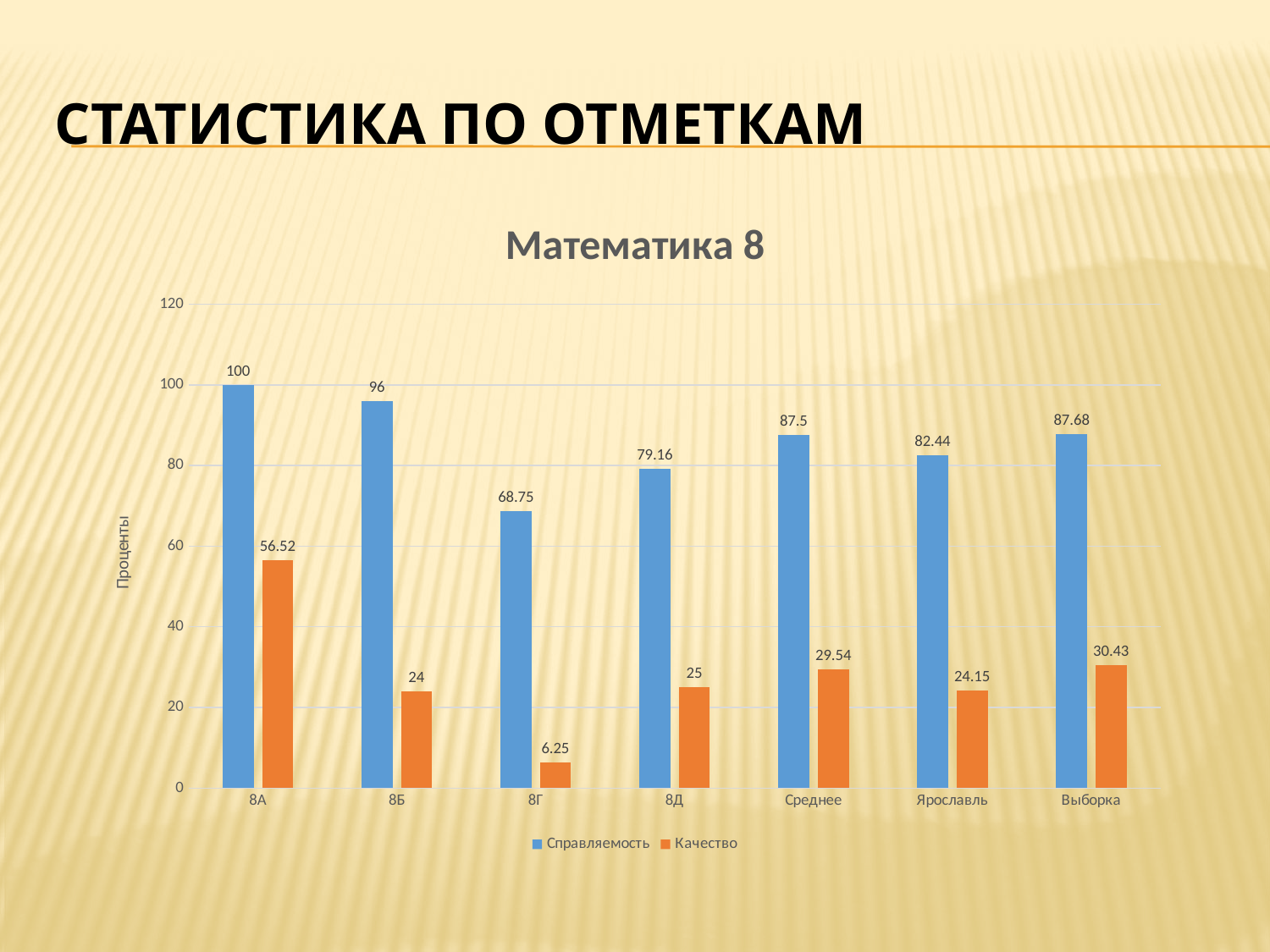
Which is larger: the Качество value for Среднее or for Выборка? Выборка What is the difference between the Справляемость and Качество values for 8Б? 72 Which category has the lowest Качество value? 8Г What is the Качество value for Ярославль? 24.15 Which category has the highest Справляемость value? 8А How many series does the legend list? 2 What is the label of the vertical axis? Проценты How many categories are shown on the x axis? 7 What is the Справляемость value for 8Г? 68.75 What is the title of the chart? Математика 8 What kind of chart is shown? bar chart Is the Справляемость value for 8Д greater or less than 80? less